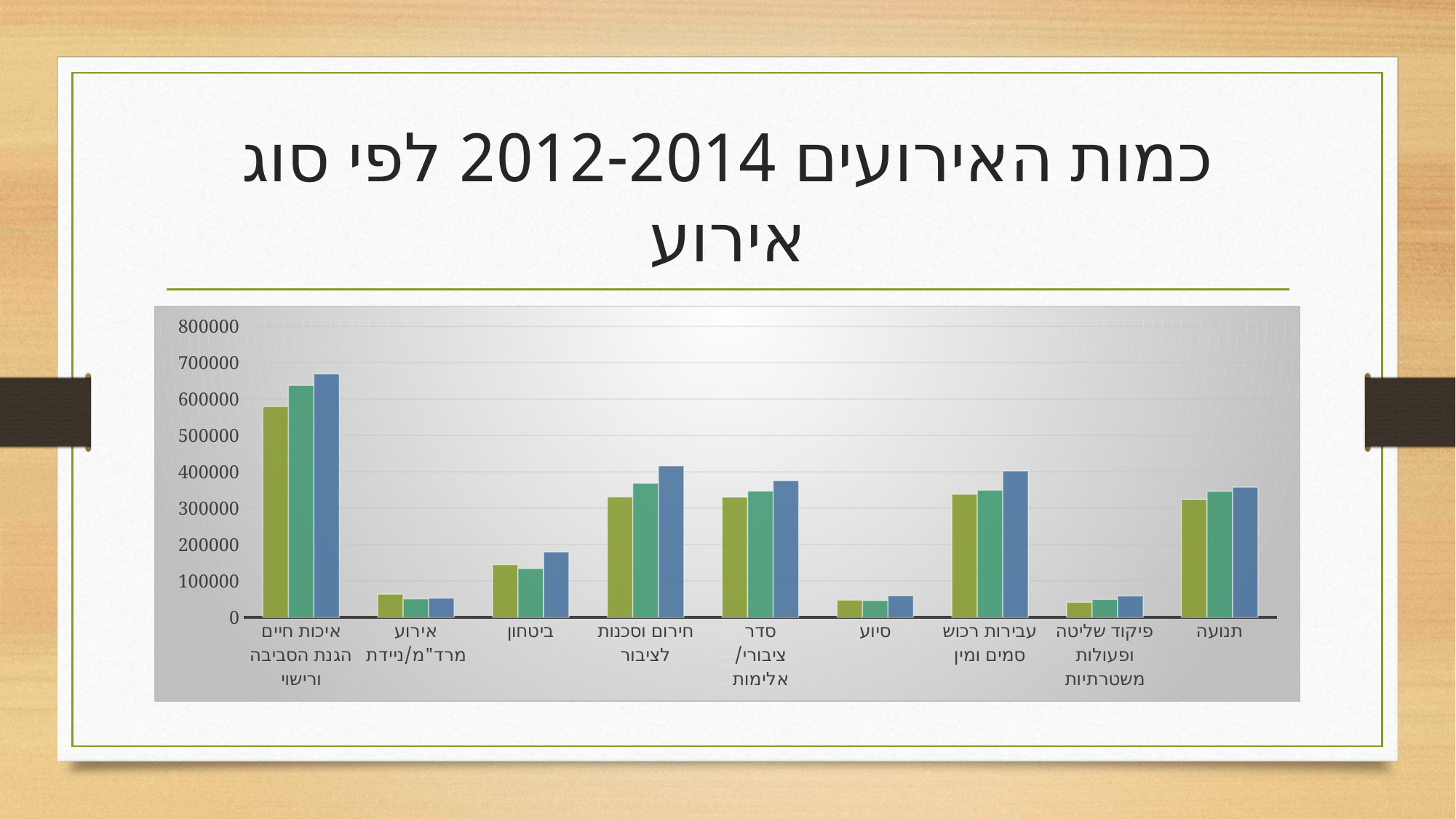
What is the title of the chart slide? כמות האירועים 2012-2014 לפי סוג אירוע Is the value of the olive-green bar for איכות חיים הגנת הסביבה ורישוי greater or less than 500000? greater Is the value of the blue bar for חירום וסכנות לציבור greater or less than 300000? greater Is the value of the blue bar for תנועה greater or less than 300000? greater How many event-type categories are shown on the x axis of the chart? 9 How many bars are plotted for each category in the chart? 3 Which category has the tallest bars in the chart? איכות חיים הגנת הסביבה ורישוי What kind of chart is shown on the slide? bar chart Which category has larger bars, ביטחון or סיוע? ביטחון